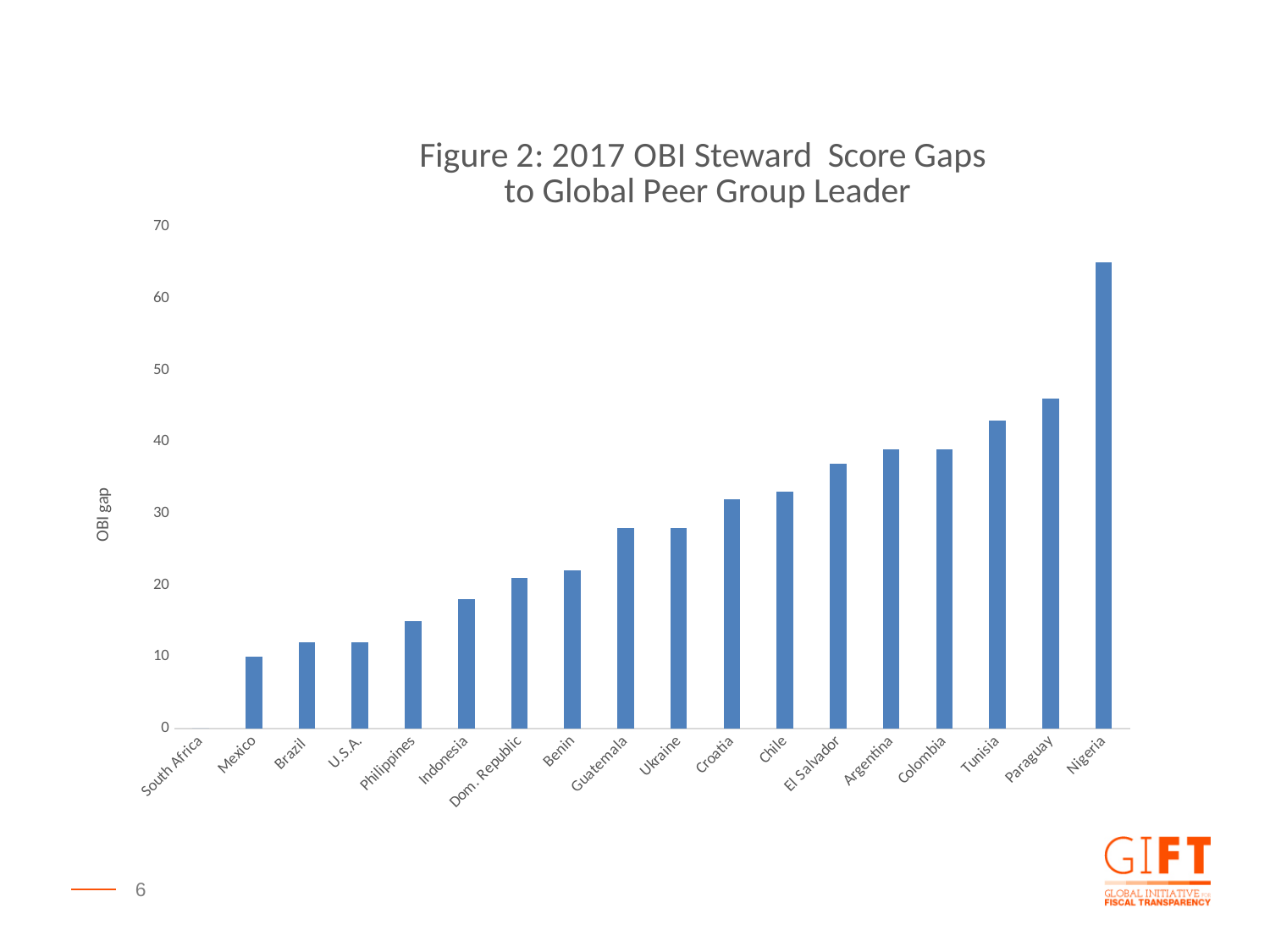
Is the value for Paraguay greater or less than 40? greater Which country has the largest OBI gap in the chart? Nigeria Is the value for Benin greater or less than 30? less Which country has the smallest OBI gap in the chart? South Africa What kind of chart is shown on the slide? bar chart How many countries are shown on the x axis of the chart? 18 Is the value for Nigeria greater or less than 60? greater Which has a larger OBI gap, Tunisia or Indonesia? Tunisia What is the OBI gap value shown for South Africa? 0 What is the label on the vertical axis of the chart? OBI gap Do the values generally rise or fall moving from left to right along the x axis? rise